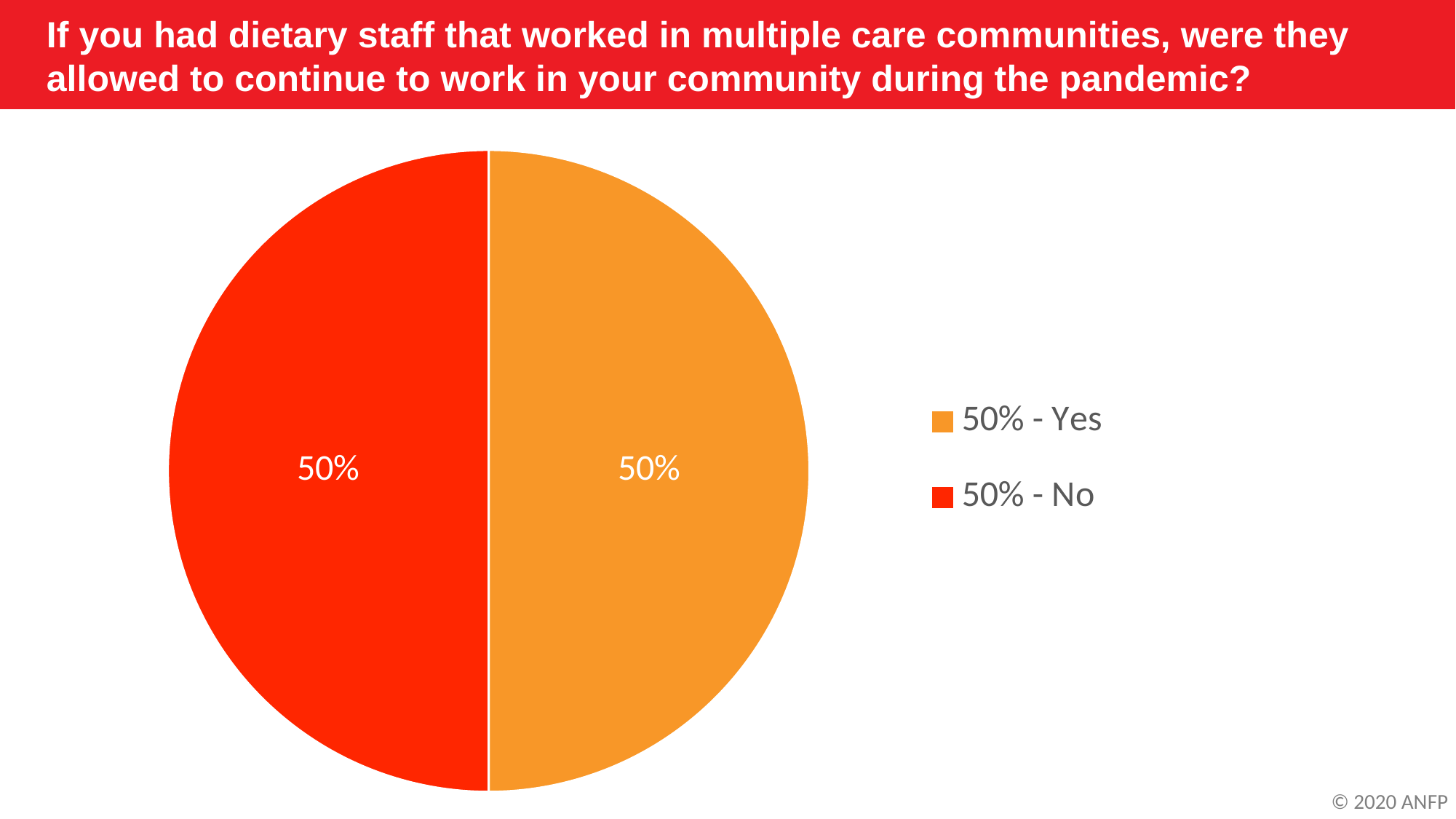
What is the combined share of the Yes and No slices? 100% Which colour represents the No response in the pie chart? red What is the difference between the Yes share and the No share? 0% What percentage of respondents answered No? 50% What kind of chart is shown on the slide? pie chart Which colour represents the Yes response in the pie chart? orange Is the share for Yes greater or less than 40%? greater How many entries does the legend list? 2 How many slices does the pie chart have? 2 What percentage of respondents answered Yes? 50%